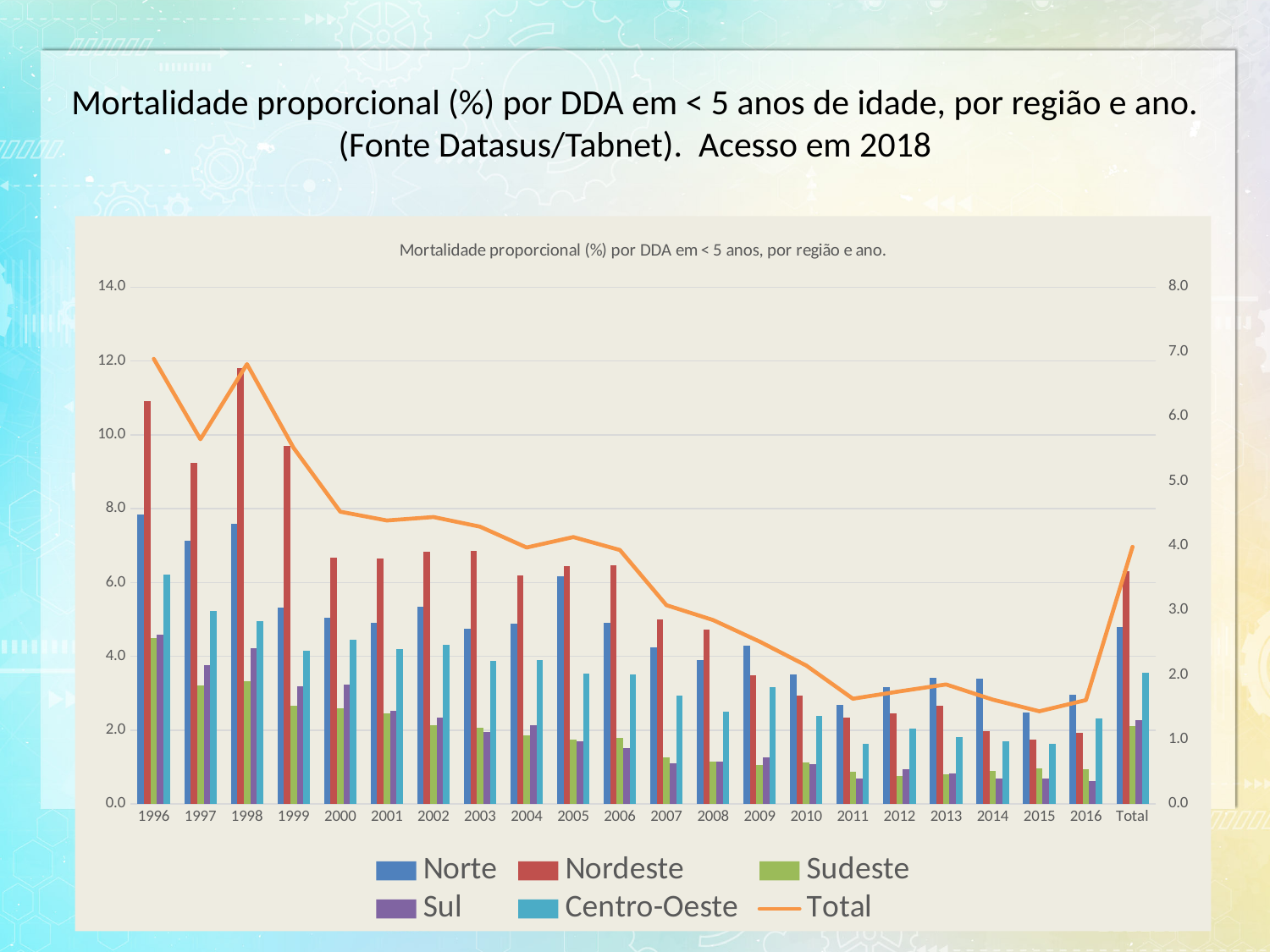
Is the value for Sudeste in 2016 greater or less than 2.0? less How many categories are shown along the x axis (years plus Total)? 22 Does the Total line generally rise or fall from 1996 to 2016? Fall Which series is drawn as a line rather than bars? Total Is the value for Norte in 1996 greater or less than 6.0? greater In which year does the Nordeste series reach its highest value? 1998 In 2014, which is larger, the Norte bar or the Nordeste bar? Norte Which region has the highest bar in 1996? Nordeste Is the value for Nordeste in 1998 greater or less than 10.0? greater How many series does the legend list? 6 What kind of chart is shown on the slide? A combined bar and line chart Which region has the lowest bar in 2000? Sudeste